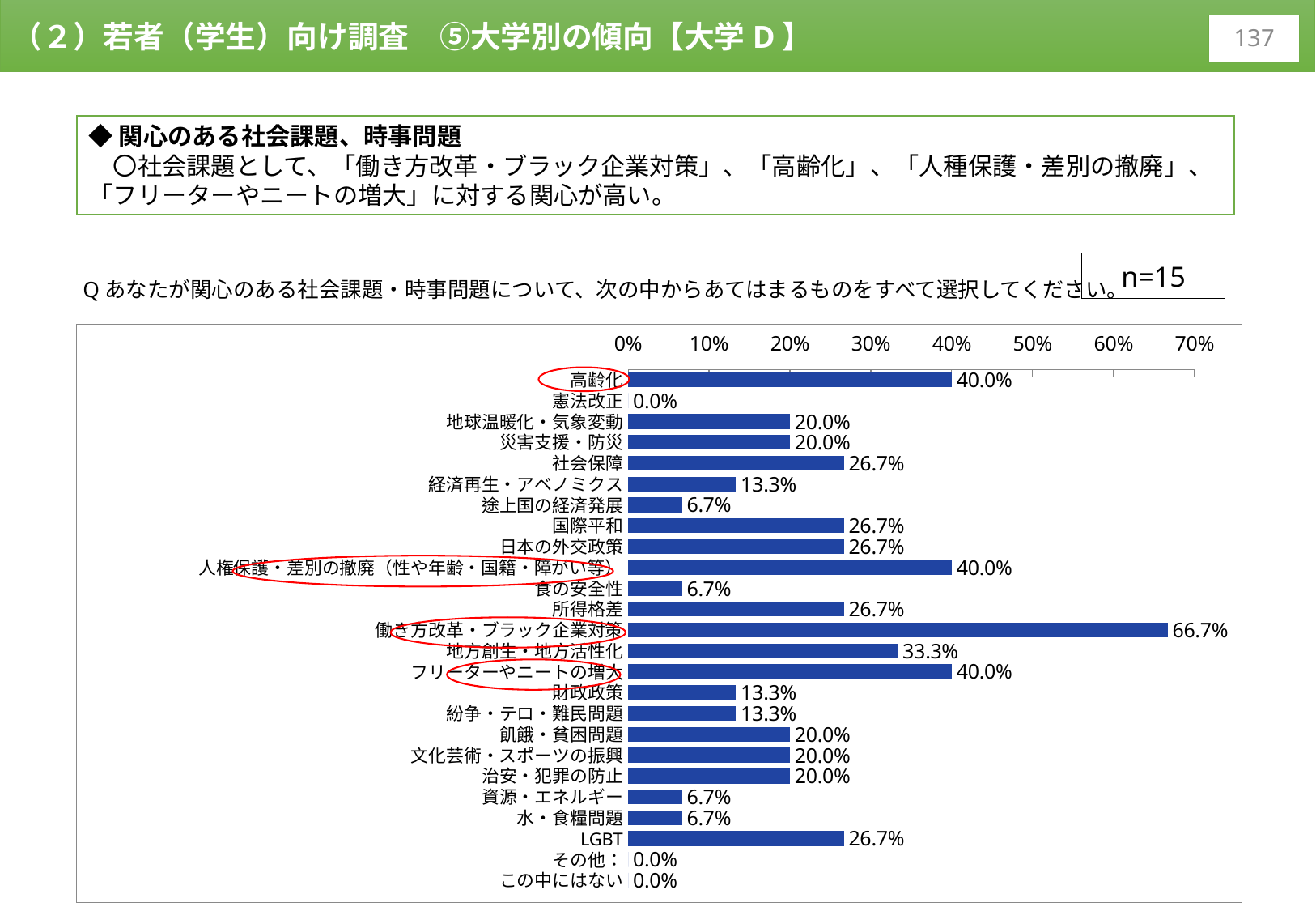
What is the difference between 働き方改革・ブラック企業対策 and 高齢化? 26.7% Is the value for フリーターやニートの増大 greater or less than 30%? greater What is the value for 地方創生・地方活性化? 33.3% What is the difference between 地方創生・地方活性化 and 財政政策? 20.0% What is the value for 社会保障? 26.7% What is the value for 途上国の経済発展? 6.7% What is the value for 働き方改革・ブラック企業対策? 66.7% What is the sample size (n) shown on the slide? n=15 Which is larger, 所得格差 or 経済再生・アベノミクス? 所得格差 What kind of chart is shown on the slide? bar chart How many categories are shown in the chart? 25 Which category has the highest value? 働き方改革・ブラック企業対策